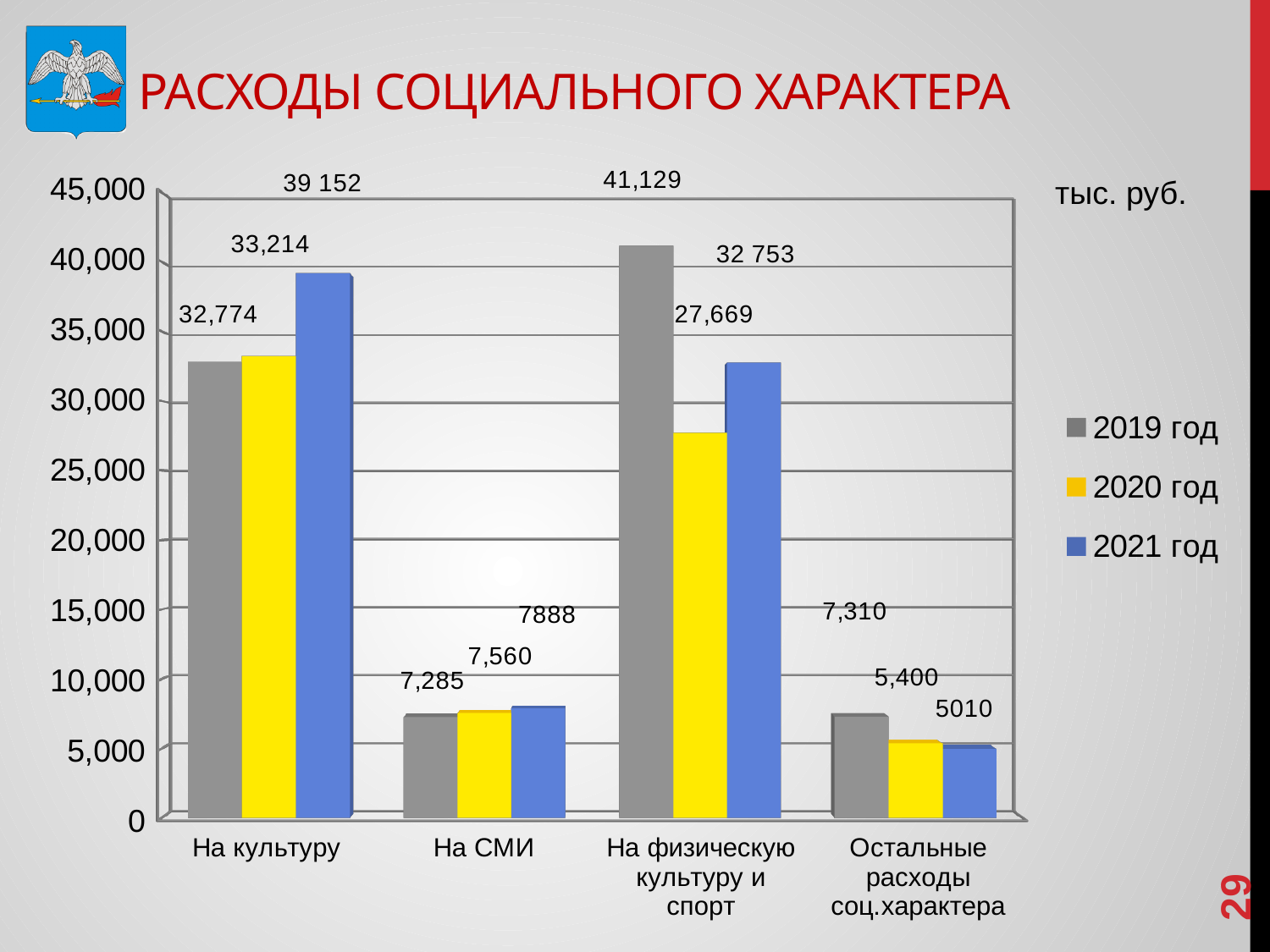
Which category has the highest value for 2019 год? На физическую культуру и спорт How many categories are shown on the x axis? 4 What is the value for 2021 год in the category На СМИ? 7888 What is the value for 2020 год in the category Остальные расходы соц.характера? 5,400 What is the value for 2019 год in the category На культуру? 32,774 Which is larger in the category На физическую культуру и спорт: the value for 2019 год or for 2020 год? 2019 год What is the difference between the 2020 год and 2019 год values in the category На культуру? 440 Which category has the lowest value for 2021 год? Остальные расходы соц.характера What unit is indicated next to the chart? тыс. руб. What type of chart is shown on the slide? bar chart What is the value for 2021 год in the category На физическую культуру и спорт? 32 753 How many series does the legend list? 3